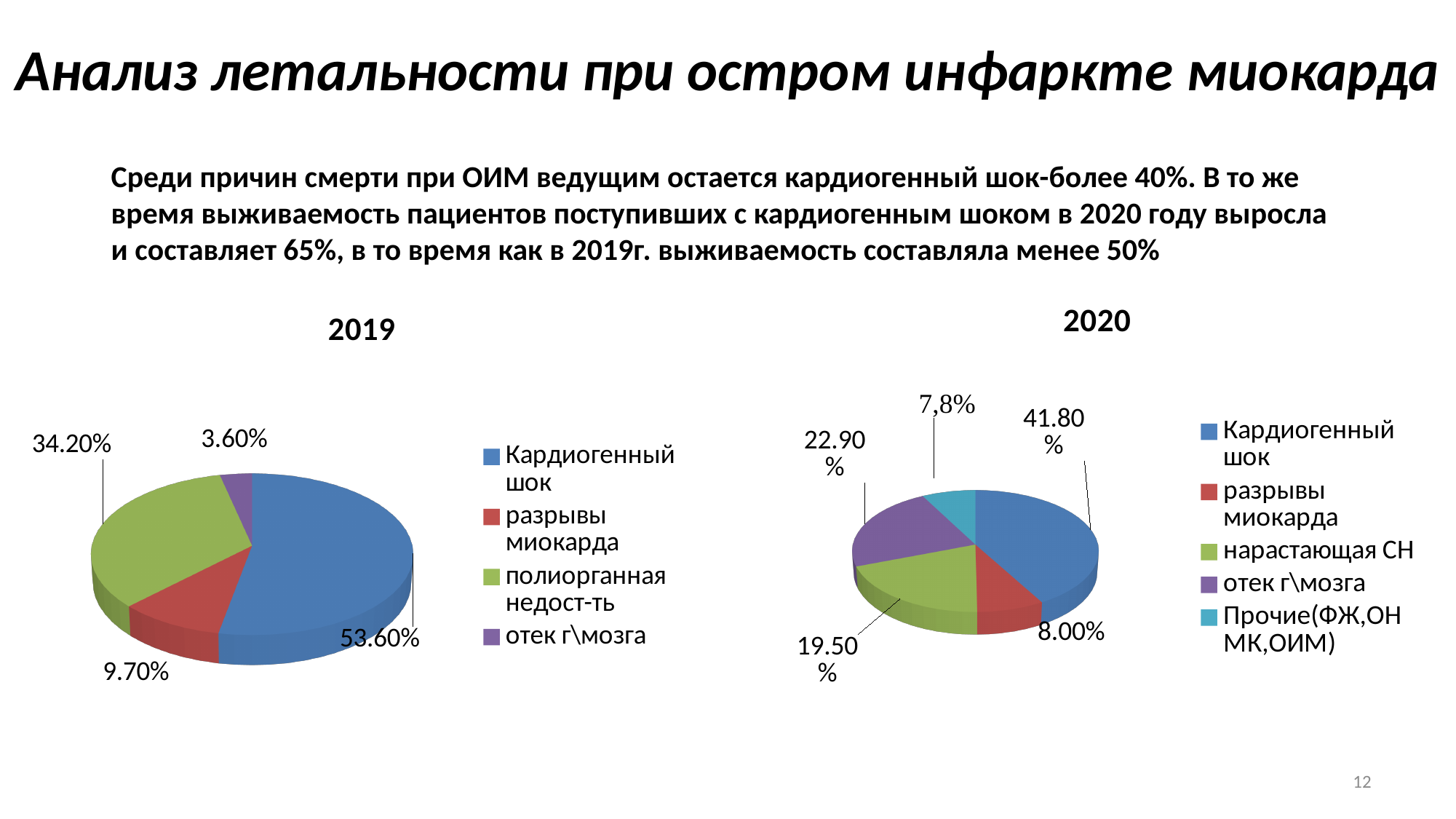
In the 2019 chart, which category has the smallest slice? отек г\мозга In the 2020 chart, which category has the largest slice? Кардиогенный шок In the 2019 chart, what is the difference between the shares for Кардиогенный шок and полиорганная недост-ть? 19.40% In the 2019 chart, what share is shown for Кардиогенный шок? 53.60% What type of chart is used for the 2020 data? Pie chart In the 2020 chart, which colour represents Прочие(ФЖ,ОН МК,ОИМ)? Light blue (cyan) In the 2020 chart, which is larger: the share for разрывы миокарда or the share for отек г\мозга? отек г\мозга In the 2019 chart, what share is shown for полиорганная недост-ть? 34.20% How many categories does the legend of the 2019 chart list? 4 In the 2020 chart, what share is shown for нарастающая СН? 19.50% How many categories does the legend of the 2020 chart list? 5 In the 2020 chart, what share is shown for отек г\мозга? 22.90%